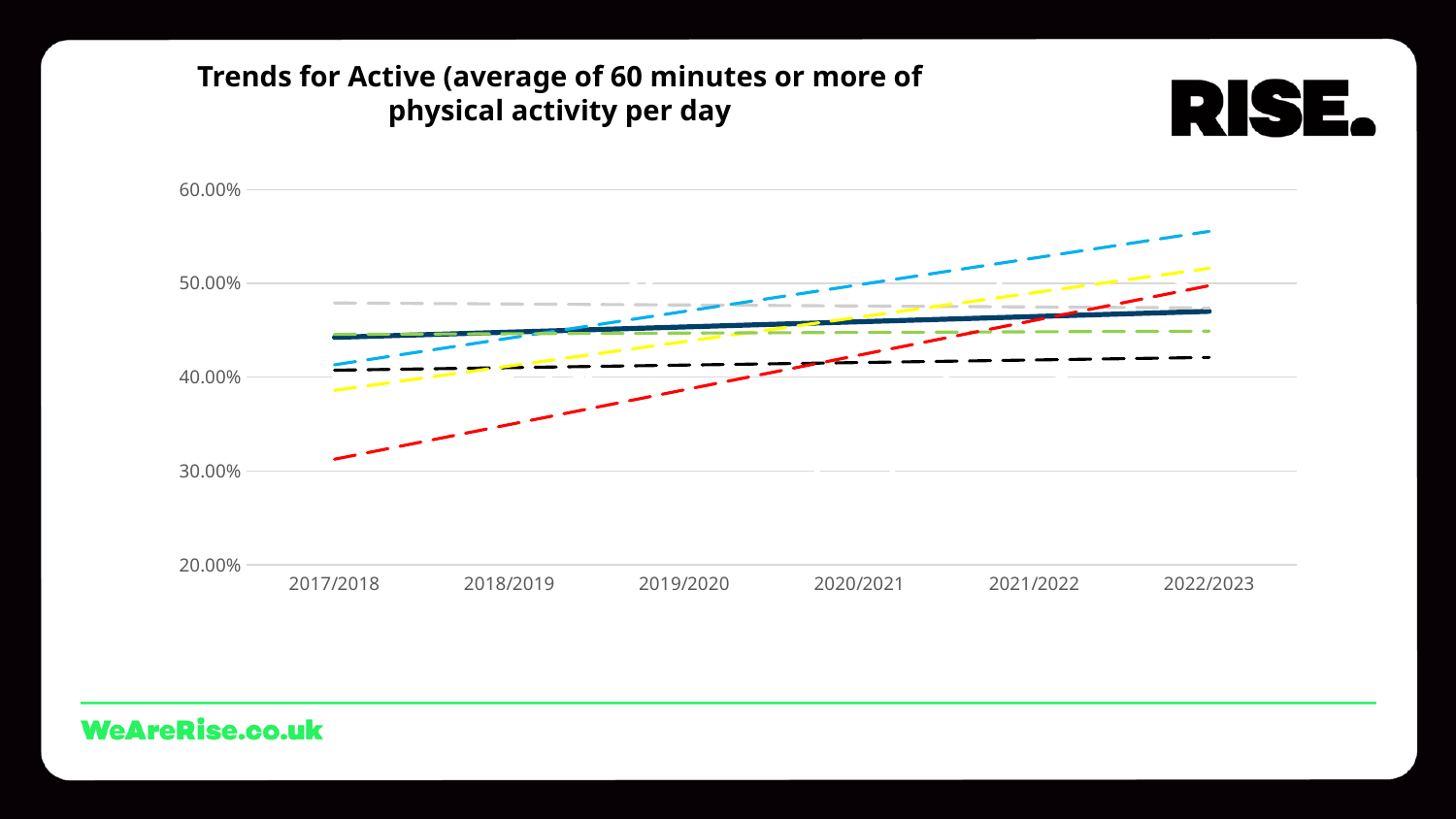
Is the value of the red dashed line at 2017/2018 greater or less than 40.00%? less At 2022/2023, which is higher: the red dashed line or the solid dark blue line? The red dashed line Which line has the lowest value at 2017/2018? The red dashed line Does the light blue dashed line rise or fall from 2017/2018 to 2022/2023? Rises Is the value of the red dashed line at 2022/2023 greater or less than 40.00%? greater What are the lowest and highest values labelled on the y axis? 20.00% and 60.00% Is the value of the light blue dashed line at 2022/2023 greater or less than 50.00%? greater Which line has the highest value at 2022/2023? The light blue dashed line Does the red dashed line rise or fall from 2017/2018 to 2022/2023? Rises What kind of chart is shown on the slide? Line chart How many academic years are shown along the x axis of the chart? 6 What is the title of the chart? Trends for Active (average of 60 minutes or more of physical activity per day